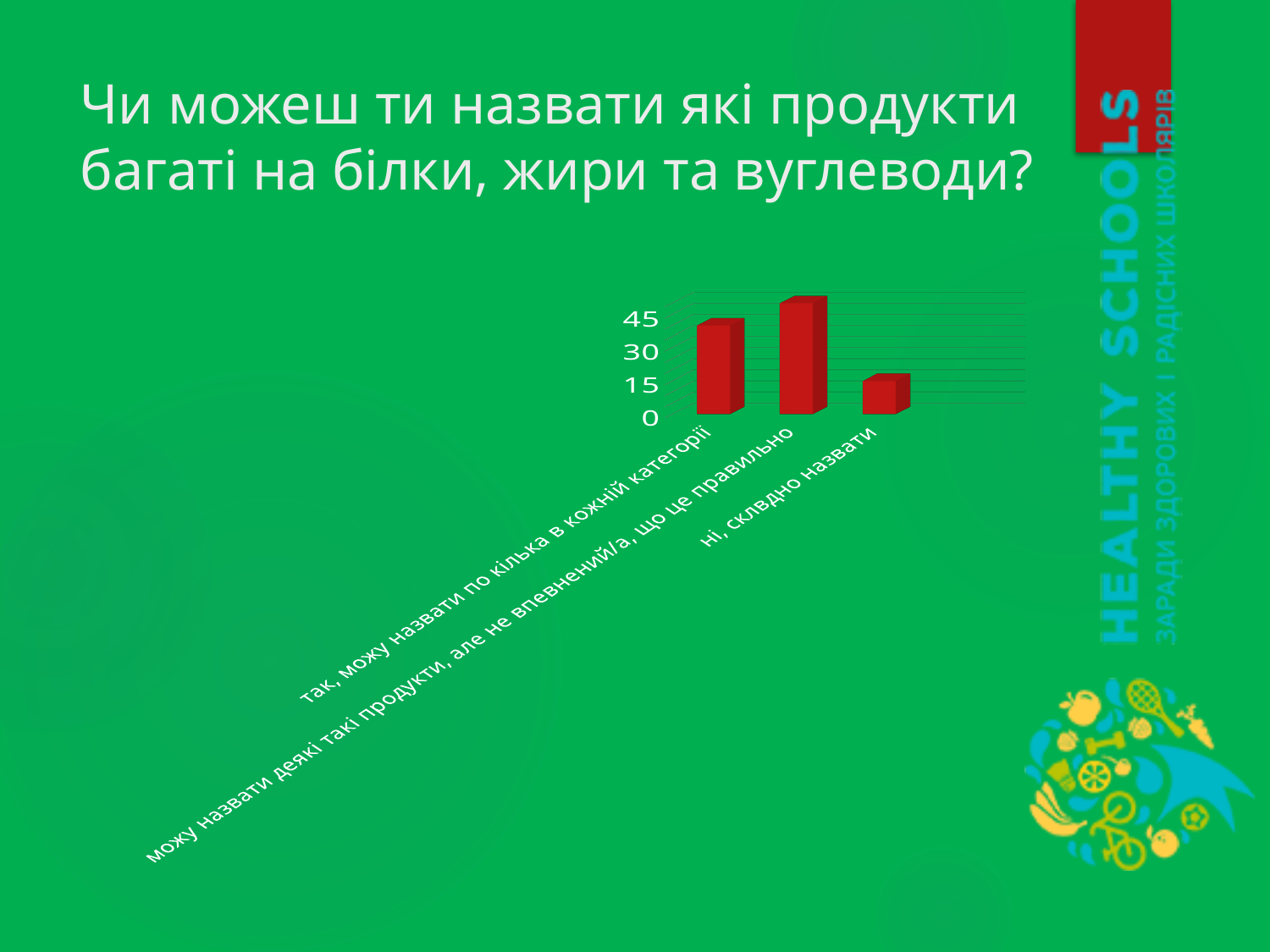
What kind of chart is shown on the slide? bar chart Which is larger: the value for "так, можу назвати по кілька в кожній категорії" or the value for "ні, склвдно назвати"? так, можу назвати по кілька в кожній категорії What is the highest tick value shown on the vertical axis of the chart? 45 What colour are the bars in the chart? red Which category has the highest bar in the chart? можу назвати деякі такі продукти, але не впевнений/а, що це правильно How many categories are shown on the x axis of the chart? 3 Is the value for "можу назвати деякі такі продукти, але не впевнений/а, що це правильно" greater or less than 30? greater Which category has the lowest bar in the chart? ні, склвдно назвати Which is larger: the value for "можу назвати деякі такі продукти, але не впевнений/а, що це правильно" or the value for "так, можу назвати по кілька в кожній категорії"? можу назвати деякі такі продукти, але не впевнений/а, що це правильно Is the value for "ні, склвдно назвати" greater or less than 30? less Is the value for "так, можу назвати по кілька в кожній категорії" greater or less than 30? greater